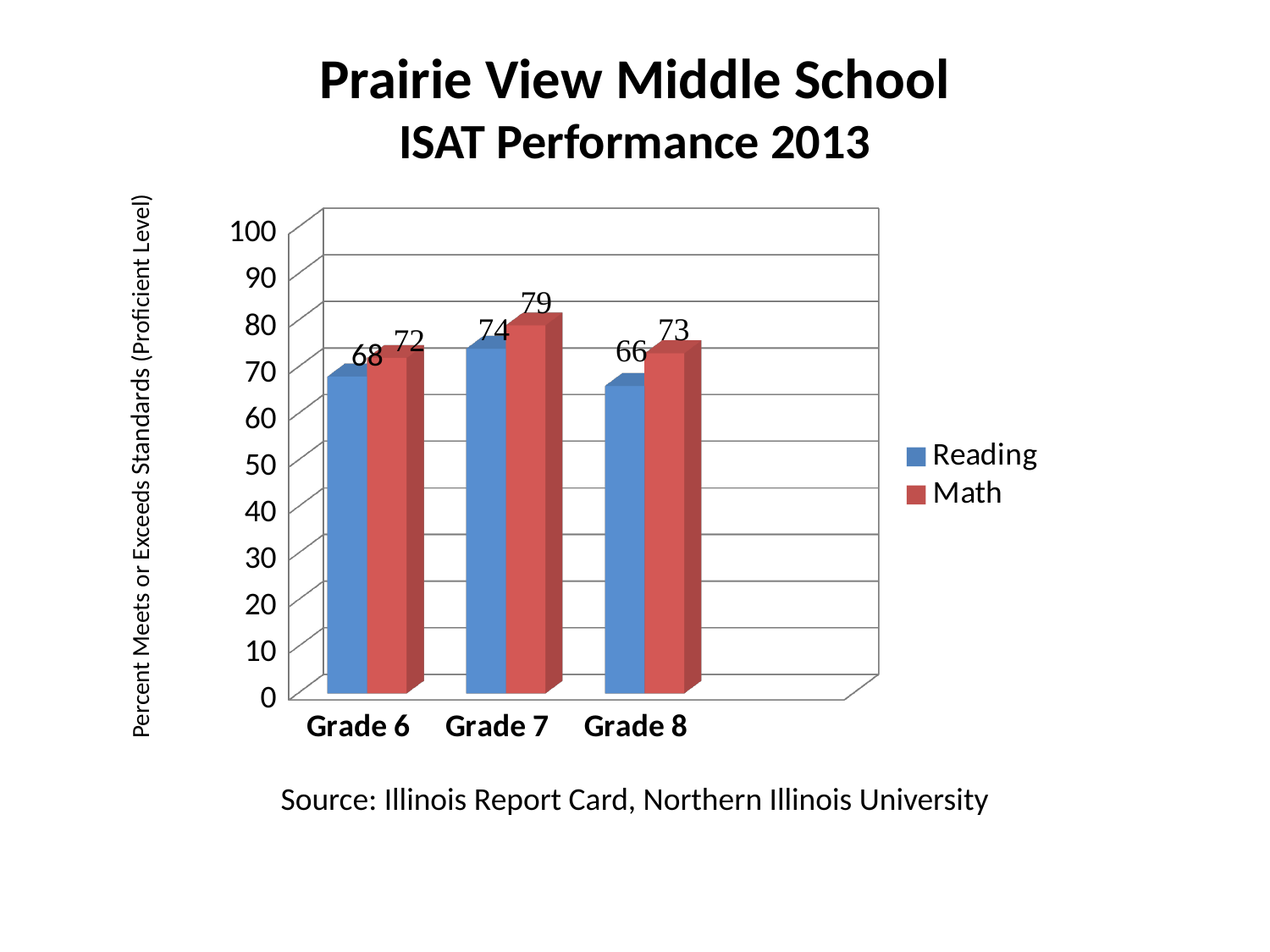
What is the difference between the Math and Reading values for Grade 8? 7 What kind of chart is shown on the slide? Bar chart What is the Math value for Grade 8? 73 Which grade has the lowest Reading value? Grade 8 Which is larger, the Reading value for Grade 7 or the Reading value for Grade 6? Reading value for Grade 7 What is the Math value for Grade 7? 79 How many series does the legend list? 2 Which grade has the highest Math value? Grade 7 What is the label of the vertical axis? Percent Meets or Exceeds Standards (Proficient Level) What is the Reading value for Grade 8? 66 What is the Reading value for Grade 6? 68 How many grades are shown on the x axis? 3